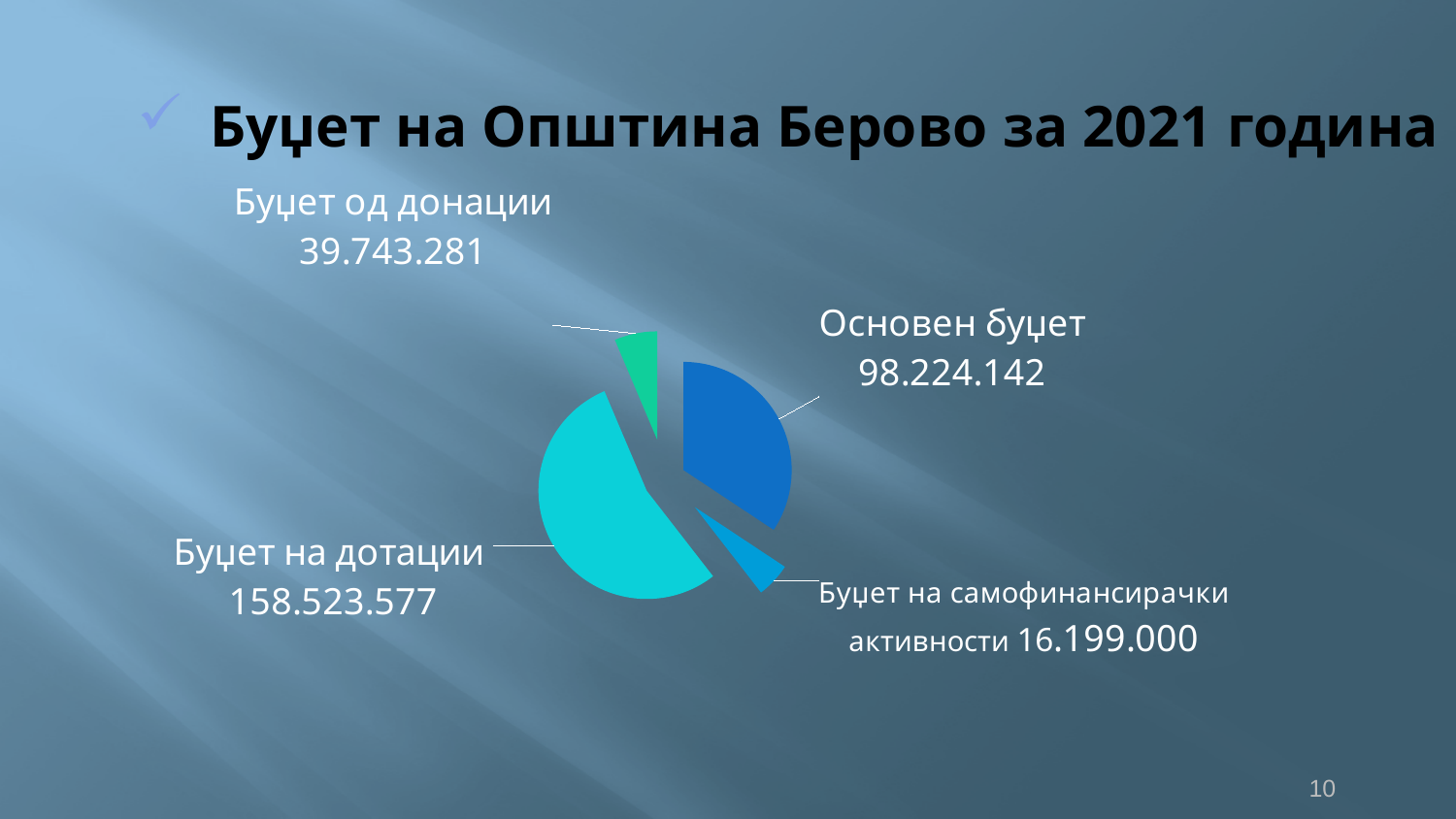
What is the value for Буџет од донации? 39.743.281 Which category has the smallest slice of the pie? Буџет на самофинансирачки активности What is the value for Буџет на самофинансирачки активности? 16.199.000 Which category has the largest slice of the pie? Буџет на дотации What is the value for Буџет на дотации? 158.523.577 How many slices does the pie chart have? 4 What is the title of the slide containing the pie chart? Буџет на Општина Берово за 2021 година What is the difference between Буџет на дотации and Основен буџет? 60.299.435 Which is larger, Основен буџет or Буџет од донации? Основен буџет What is the difference between Буџет од донации and Буџет на самофинансирачки активности? 23.544.281 What kind of chart is shown on the slide? Pie chart What is the value for Основен буџет? 98.224.142